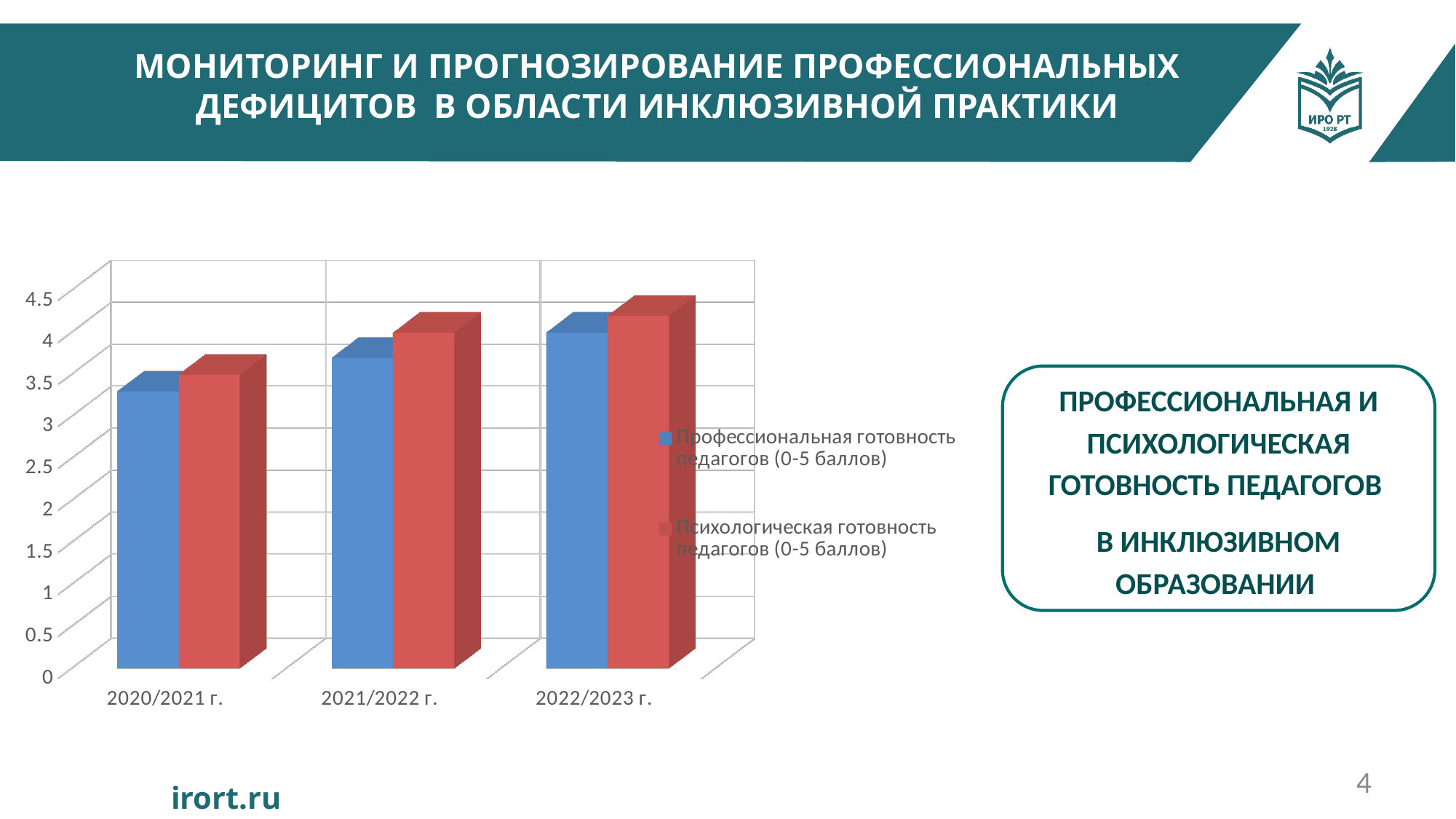
How many series does the chart legend list? 2 Which academic year has the lowest value for Психологическая готовность педагогов (0-5 баллов)? 2020/2021 г. In 2020/2021 г., which series has the larger value: Профессиональная готовность педагогов or Психологическая готовность педагогов? Психологическая готовность педагогов Is the value for Профессиональная готовность педагогов in 2020/2021 г. greater or less than 3? greater What is the first series listed in the chart legend? Профессиональная готовность педагогов (0-5 баллов) Is the value for Профессиональная готовность педагогов in 2021/2022 г. greater or less than 4? less Which colour represents Психологическая готовность педагогов (0-5 баллов) in the chart? red Do the values for Профессиональная готовность педагогов rise or fall from 2020/2021 г. to 2022/2023 г.? rise Which academic year has the highest value for Профессиональная готовность педагогов (0-5 баллов)? 2022/2023 г. How many academic years are shown on the x axis of the chart? 3 Is the value for Психологическая готовность педагогов in 2022/2023 г. greater or less than 3.5? greater What kind of chart is shown on the slide? bar chart